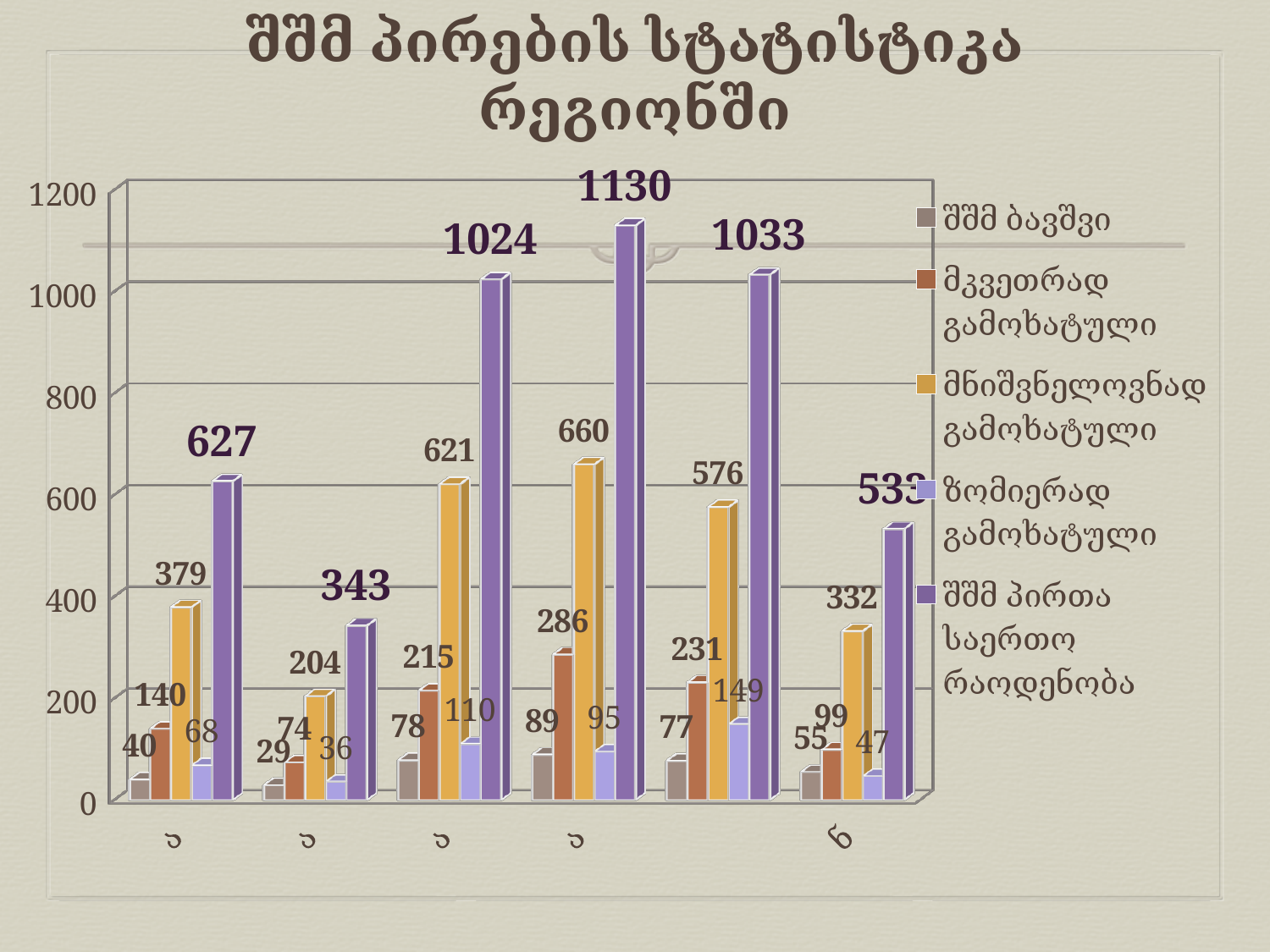
What kind of chart is shown on the slide? bar chart Which is larger: the მკვეთრად გამოხატული value in the fourth group (286) or in the fifth group (231)? the fourth group (286) Which group of bars has the highest შშმ პირთა საერთო რაოდენობა value? the fourth group (1130) What is the difference between the შშმ პირთა საერთო რაოდენობა values of the fourth group (1130) and the fifth group (1033)? 97 What is the title of the chart? შშმ პირების სტატისტიკა რეგიონში What is the value of the tallest bar (შშმ პირთა საერთო რაოდენობა) in the fourth group from the left? 1130 What is the value of the მნიშვნელოვნად გამოხატული bar in the third group from the left? 621 How many groups of bars are plotted along the x axis? 6 Which group of bars has the lowest შშმ პირთა საერთო რაოდენობა value? the second group (343) How many series does the legend list? 5 Is the შშმ პირთა საერთო რაოდენობა value in the third group greater or less than 1000? greater What is the value of the შშმ ბავშვი bar in the first group from the left? 40